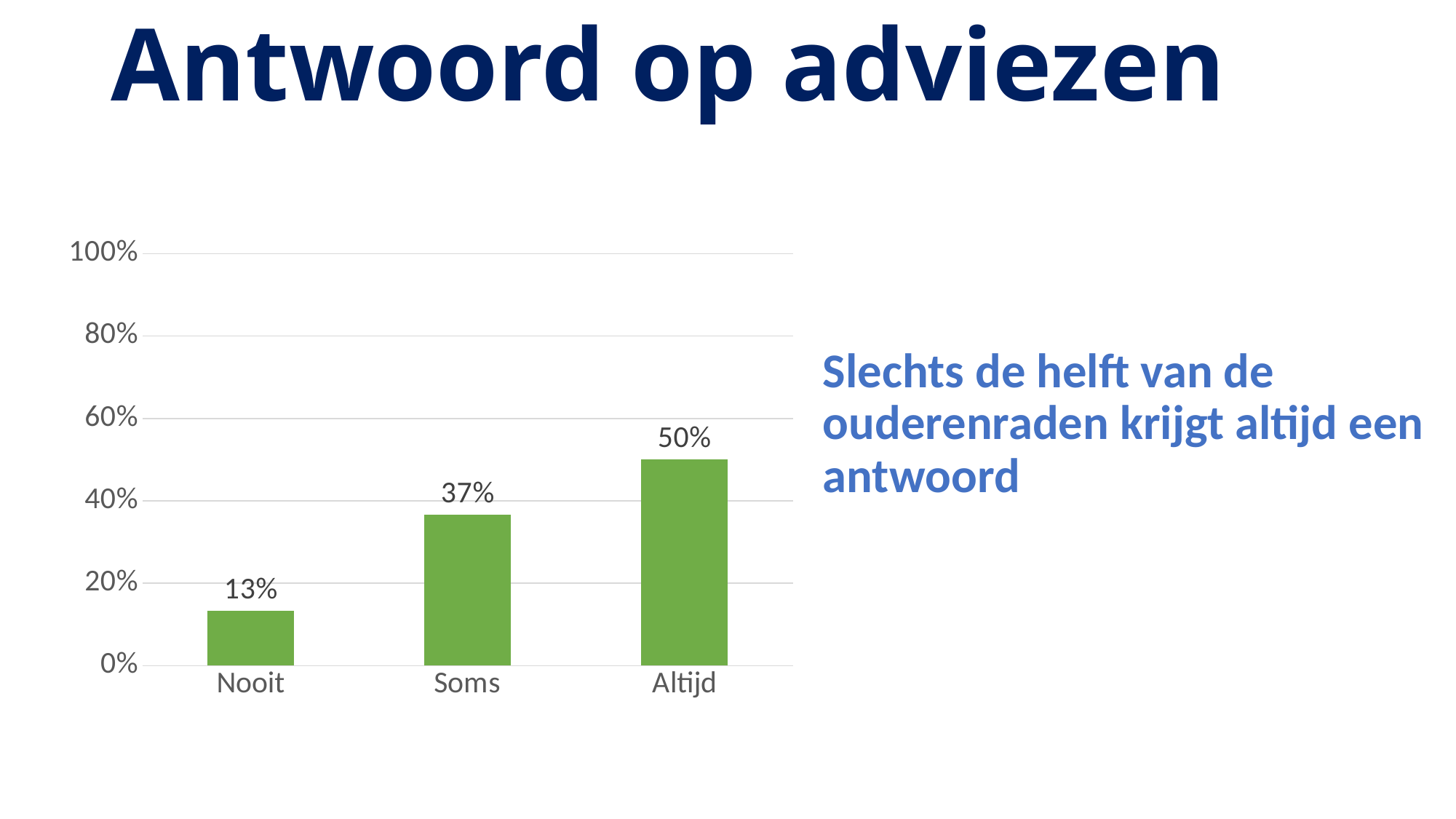
Which category has the highest value? Altijd Is the value for Soms greater or less than 40%? less What is the value for Nooit? 13% Do the values rise or fall from Nooit to Altijd along the x axis? rise How many categories are shown on the x axis? 3 What is the value for Soms? 37% What is the difference between the values for Altijd and Soms? 13% Which category has the lowest value? Nooit Which is larger, the value for Soms or the value for Nooit? Soms What is the difference between the values for Soms and Nooit? 24% What is the value for Altijd? 50% What kind of chart is shown on the slide? bar chart